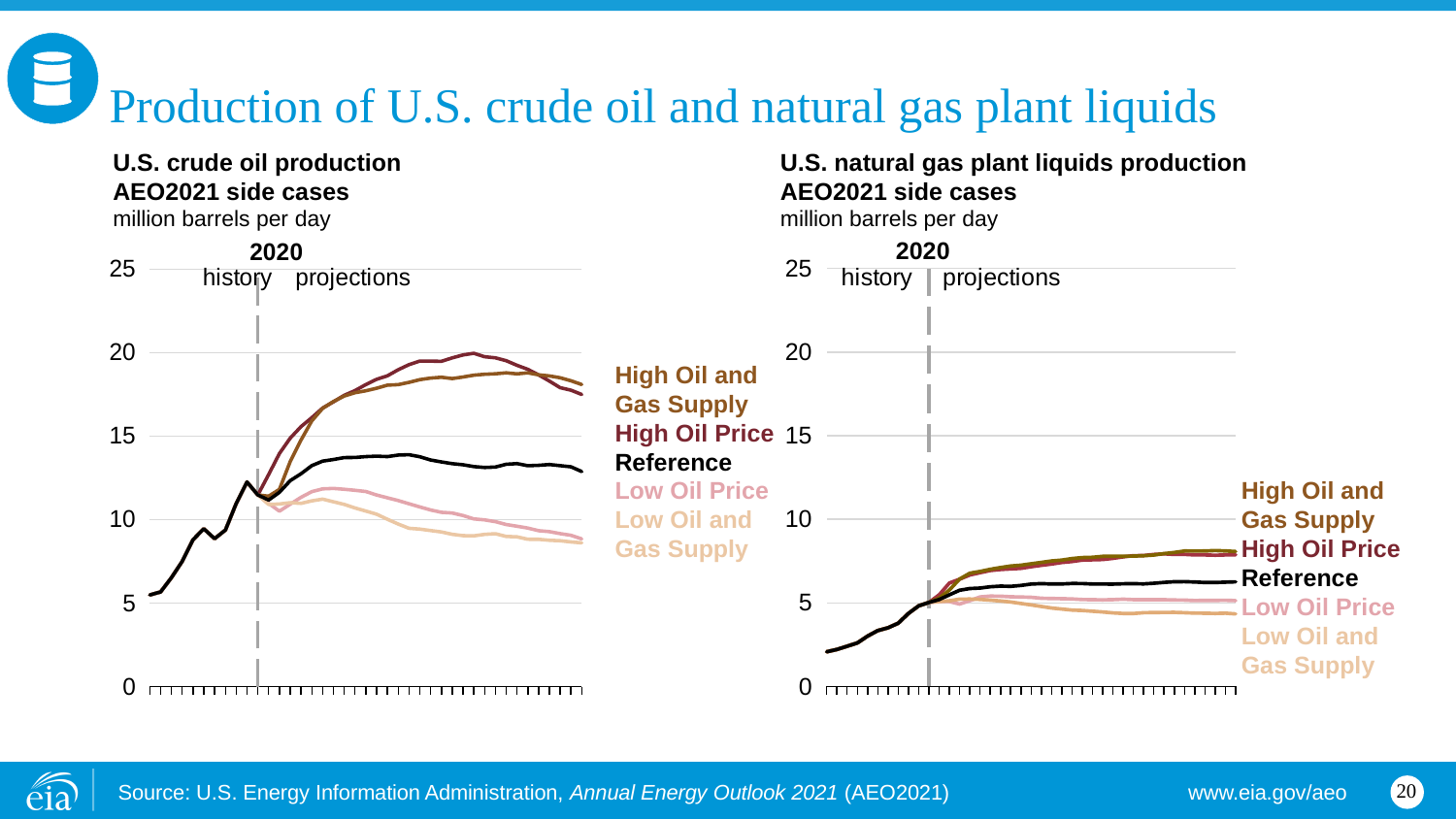
In the U.S. crude oil production chart, which series is highest at the end of the projection period? High Oil and Gas Supply In the U.S. natural gas plant liquids production chart, is the Low Oil and Gas Supply value at the end of the projection period greater or less than 5? less How many series does the legend of the U.S. natural gas plant liquids production chart list? 5 In the U.S. natural gas plant liquids production chart, is the High Oil and Gas Supply value at the end of the projection period greater or less than 10? less In the U.S. crude oil production chart, does the Low Oil and Gas Supply line rise or fall over the projection period? fall In the U.S. crude oil production chart, is the Low Oil and Gas Supply value at the end of the projection period greater or less than 10? less What unit is used on the y axis of both charts? million barrels per day In the U.S. natural gas plant liquids production chart, at the end of the projection period, which is larger: Reference or Low Oil Price? Reference What kind of chart is the U.S. crude oil production chart? line chart In the U.S. natural gas plant liquids production chart, which series is lowest at the end of the projection period? Low Oil and Gas Supply